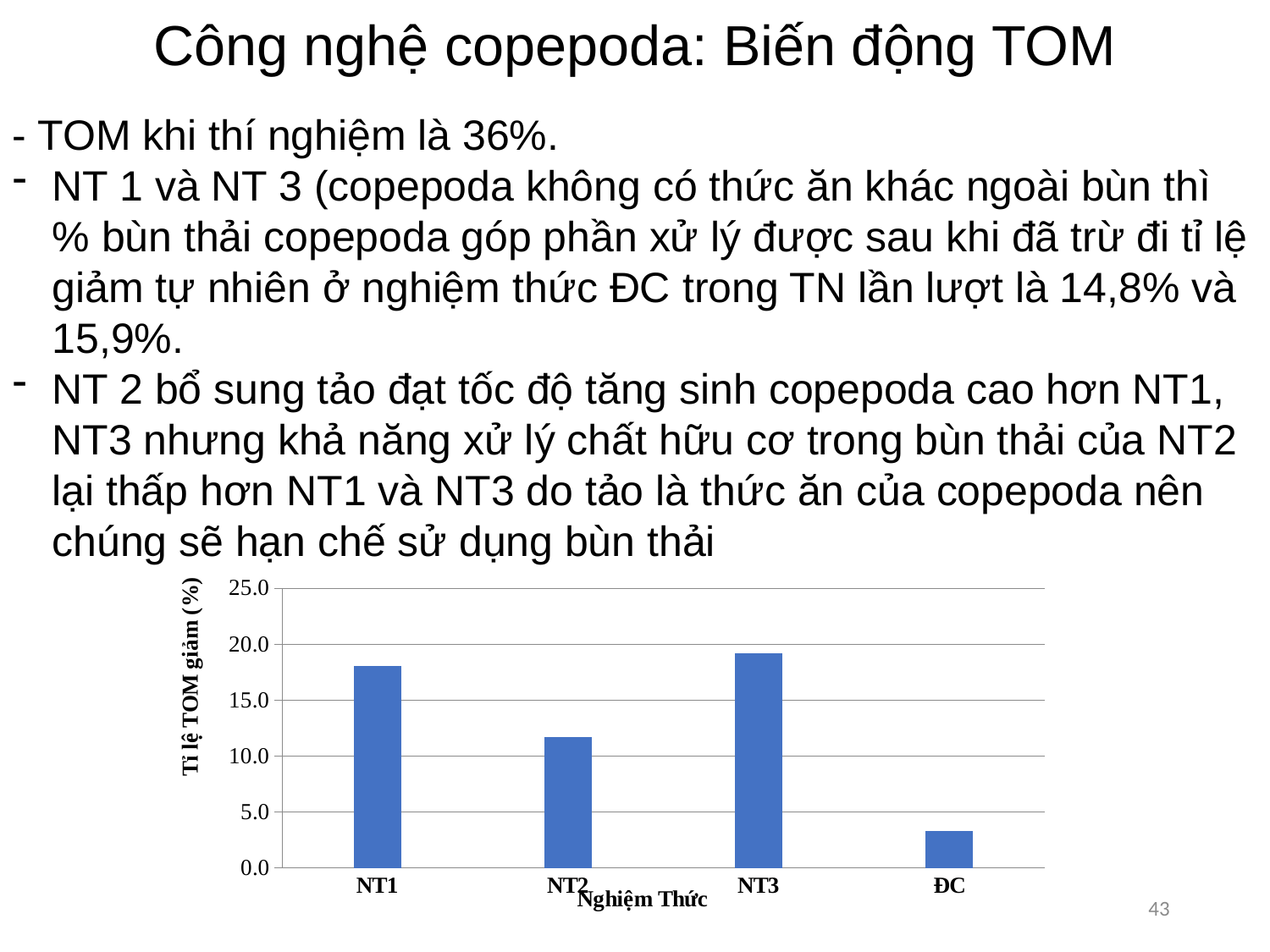
Which has a larger value, NT1 or NT2? NT1 Is the value for NT2 greater or less than 15.0? less Is the value for NT1 greater or less than 15.0? greater How many categories are shown on the x axis of the chart? 4 Is the value for NT3 greater or less than 20.0? less What kind of chart is shown on the slide? bar chart Which category has the highest value in the chart? NT3 What is the label of the x axis of the chart? Nghiệm Thức What is the label of the y axis of the chart? Tỉ lệ TOM giảm (%) Which category has the lowest value in the chart? ĐC